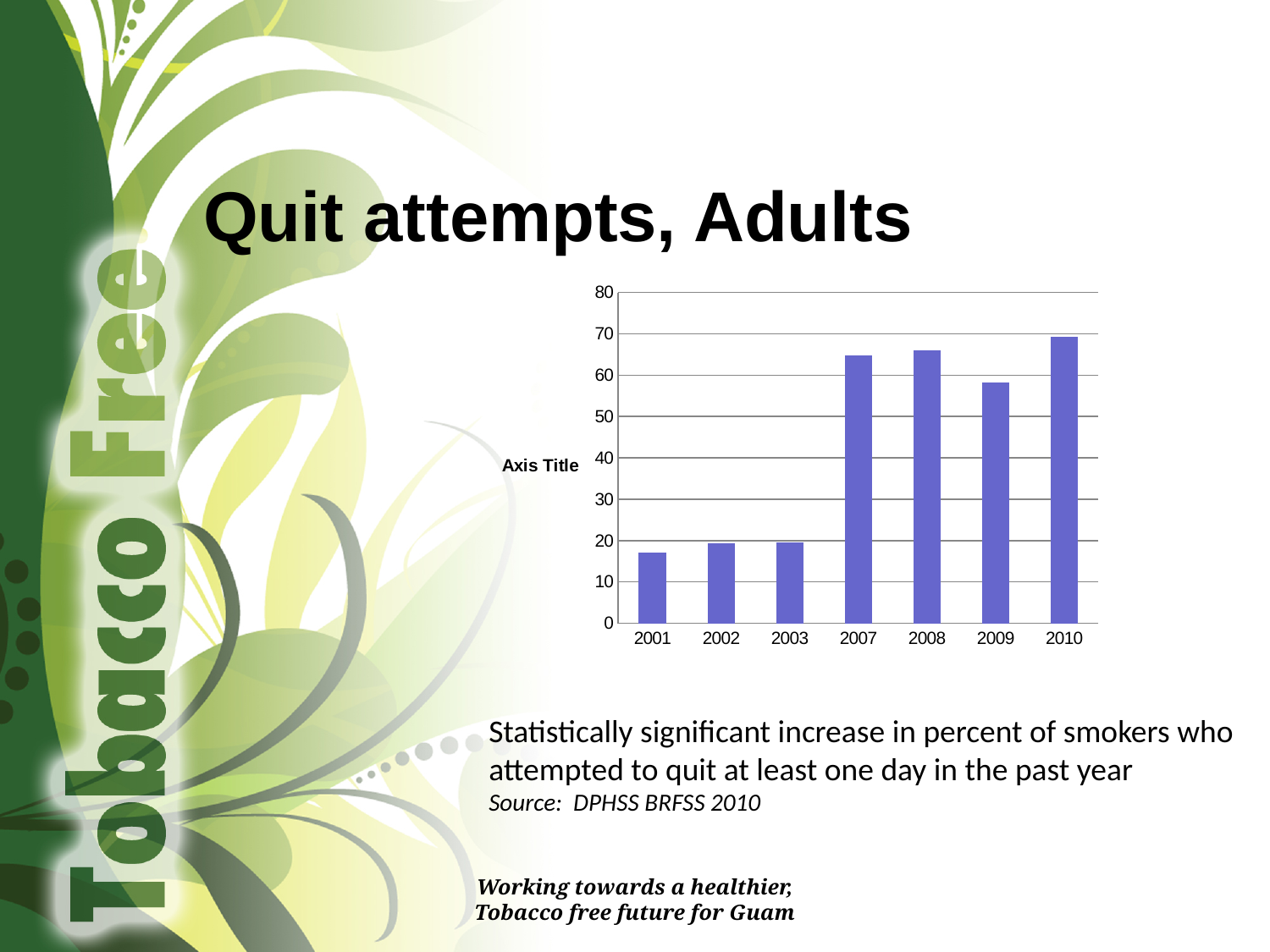
Is the value for 2003 greater or less than 30? less Is the value for 2009 greater or less than 50? greater How many years are shown on the x axis of the chart? 7 Which is larger, the value for 2003 or the value for 2007? 2007 What is the title of the slide containing the chart? Quit attempts, Adults What kind of chart is shown on the slide? bar chart Is the value for 2007 greater or less than 60? greater Which year has the highest bar in the chart? 2010 Which is larger, the value for 2008 or the value for 2009? 2008 Which year has the lowest bar in the chart? 2001 Do the values generally rise or fall from 2001 to 2010? rise